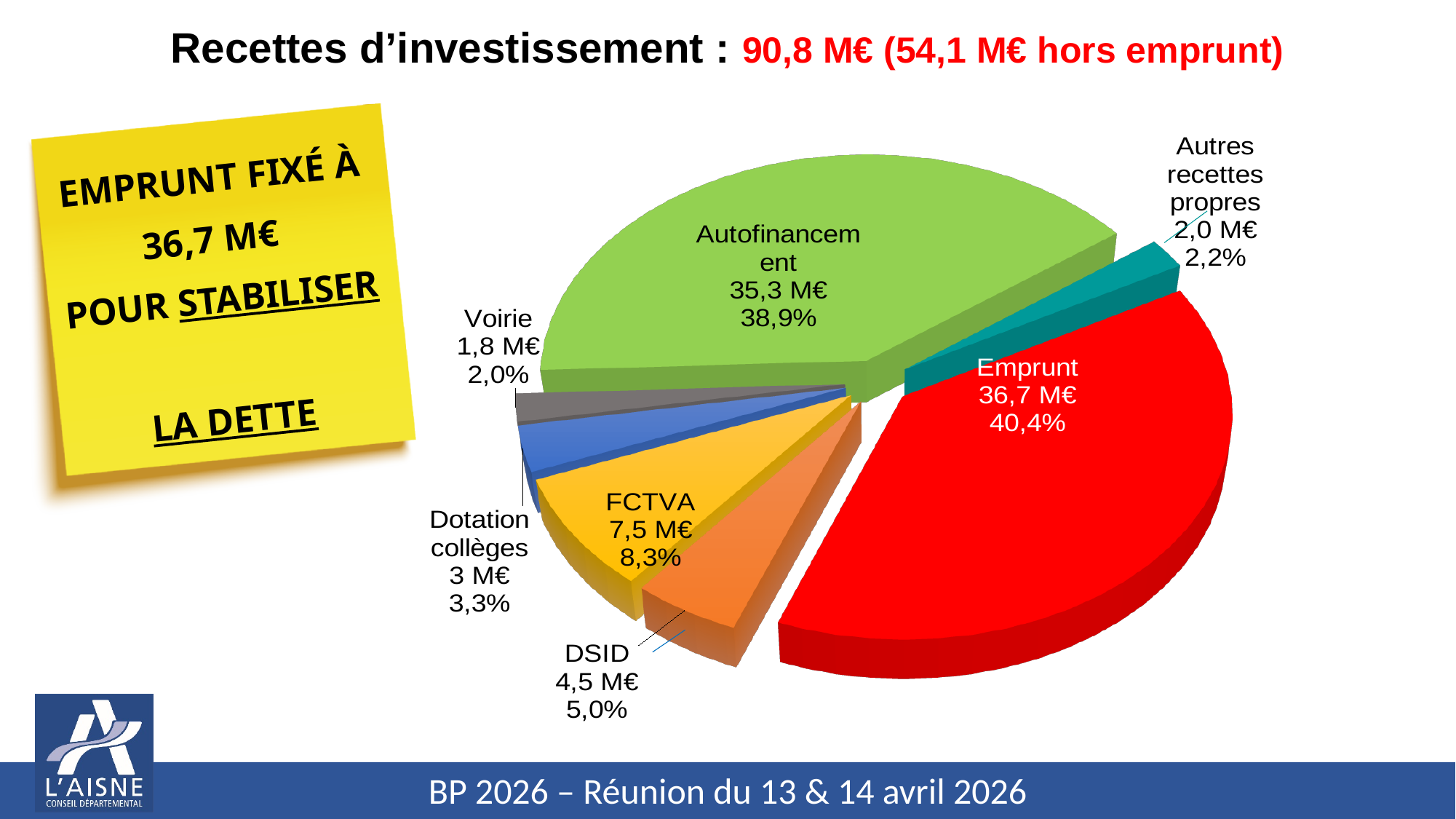
What total amount of investment revenue is stated in the slide title? 90,8 M€ Which is larger, FCTVA or DSID? FCTVA What percentage share does DSID represent? 5,0% What percentage share does Autofinancement represent? 38,9% How many slices does the pie chart have? 7 Which slice of the pie is the smallest? Voirie What is the value shown for Emprunt? 36,7 M€ Which slice of the pie is the largest? Emprunt What is the value shown for FCTVA? 7,5 M€ What is the difference in M€ between Emprunt and Autofinancement? 1,4 M€ What is the value shown for Dotation collèges? 3 M€ What type of chart is shown on the slide? pie chart